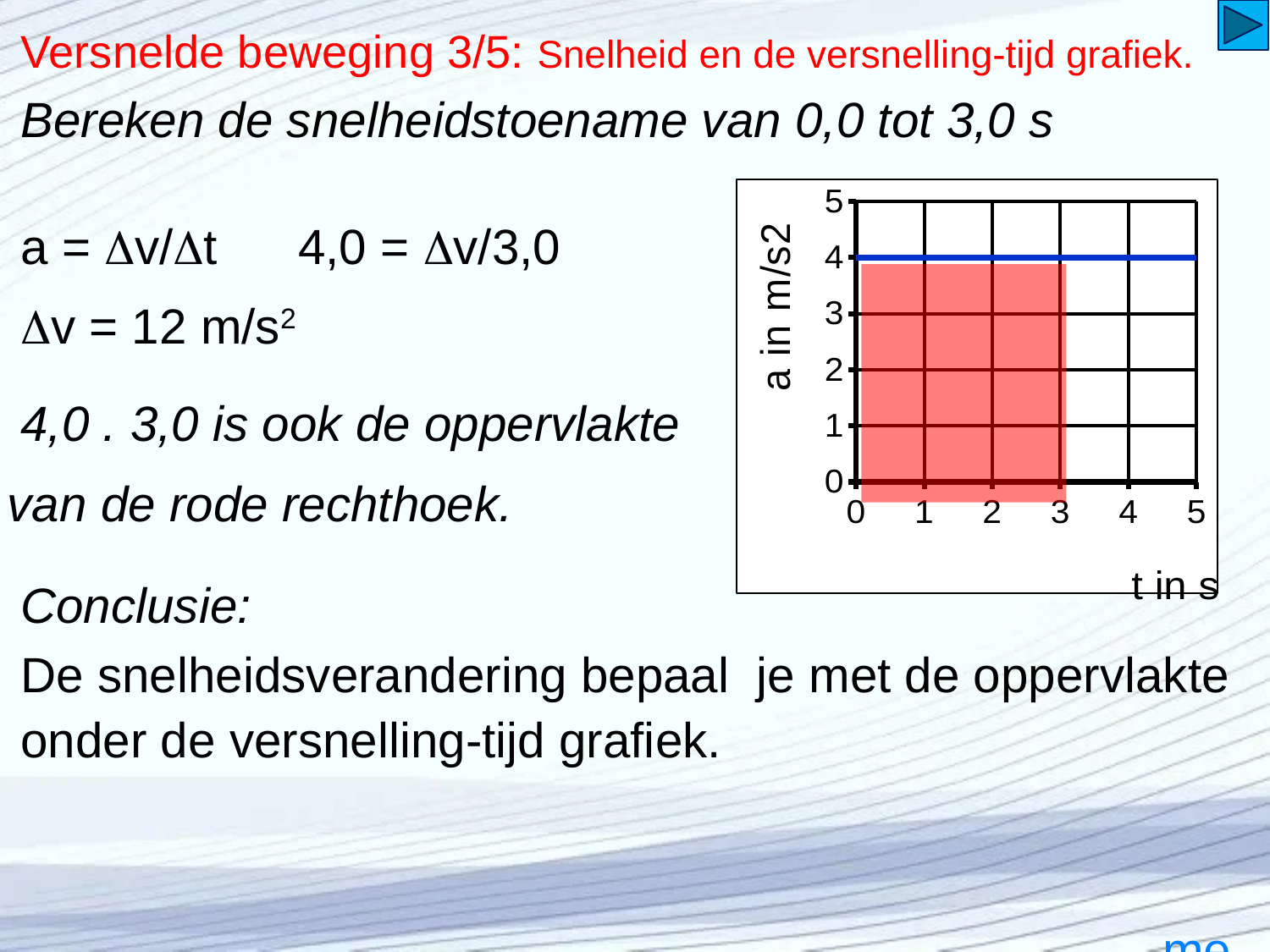
What is the label of the horizontal axis of the chart? t in s Is the value of a on the blue line at t = 1 s greater or less than 3? greater Is the value of a on the blue line at t = 4 s greater or less than 5? less What is the label of the vertical axis of the chart? a in m/s2 What value of a does the blue line have at t = 0 s? 4 At which value of t does the red rectangle end on the horizontal axis? 3 Up to which value of a does the red rectangle extend on the vertical axis? 4 What value of a does the blue line have at t = 2 s? 4 Does the blue line rise, fall, or stay constant as t increases from 0 to 5 s? stays constant What kind of chart is shown on the slide? line chart What is the highest value shown on the vertical axis of the chart? 5